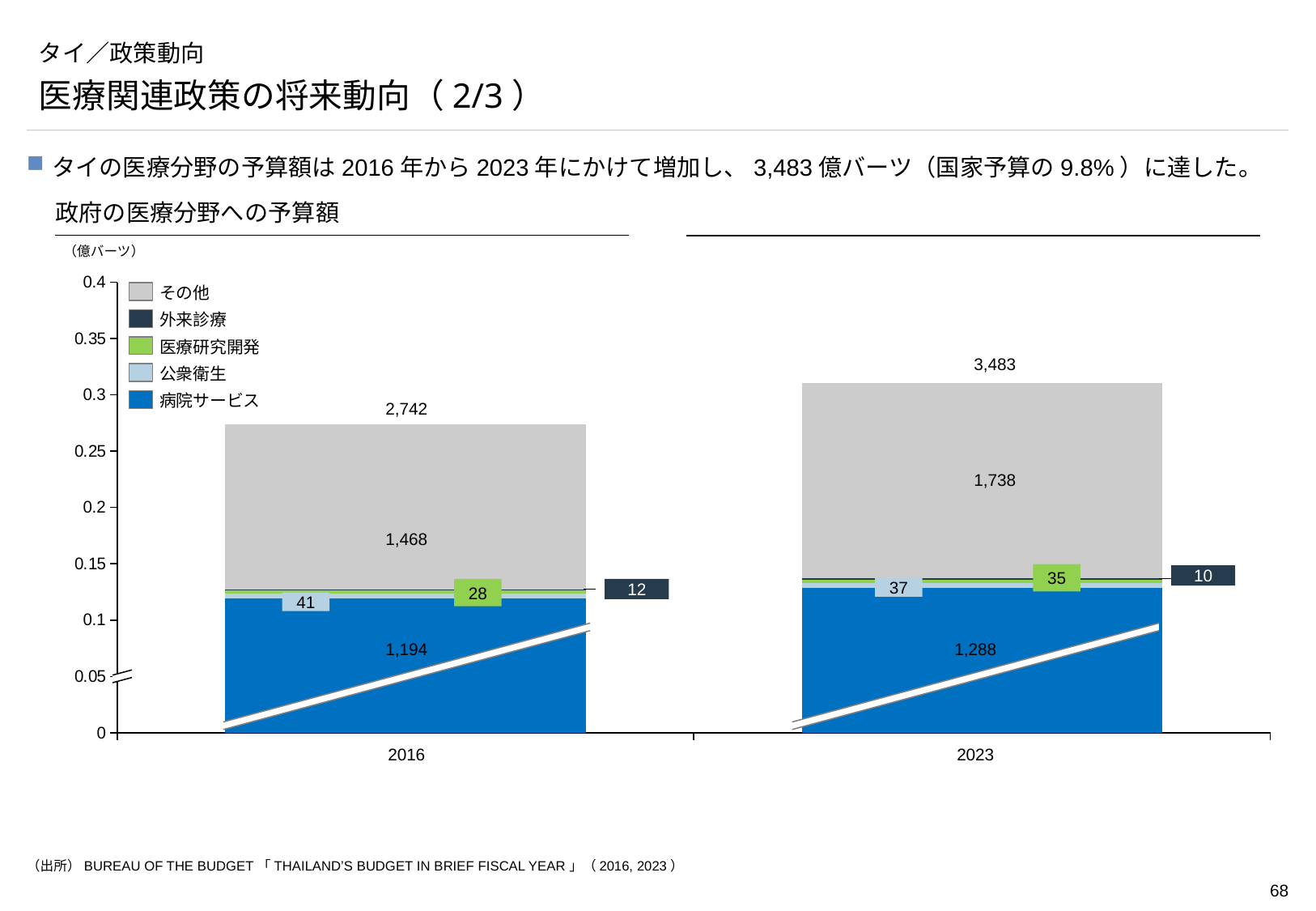
How much did the value of 病院サービス increase from 2016 to 2023? 94 How many series does the legend list? 5 What is the total budget shown for 2023 in the chart 政府の医療分野への予算額? 3,483 What is the total budget shown for 2016 in the chart 政府の医療分野への予算額? 2,742 What kind of chart is shown on the slide? Stacked bar chart Which year has the larger value for 公衆衛生, 2016 or 2023? 2016 What is the value of 病院サービス for 2016? 1,194 What is the value of 公衆衛生 for 2016? 41 What is the value of その他 for 2023? 1,738 What is the value of 医療研究開発 for 2023? 35 What is the value of 外来診療 for 2023? 10 How many years (categories) are shown on the x axis? 2